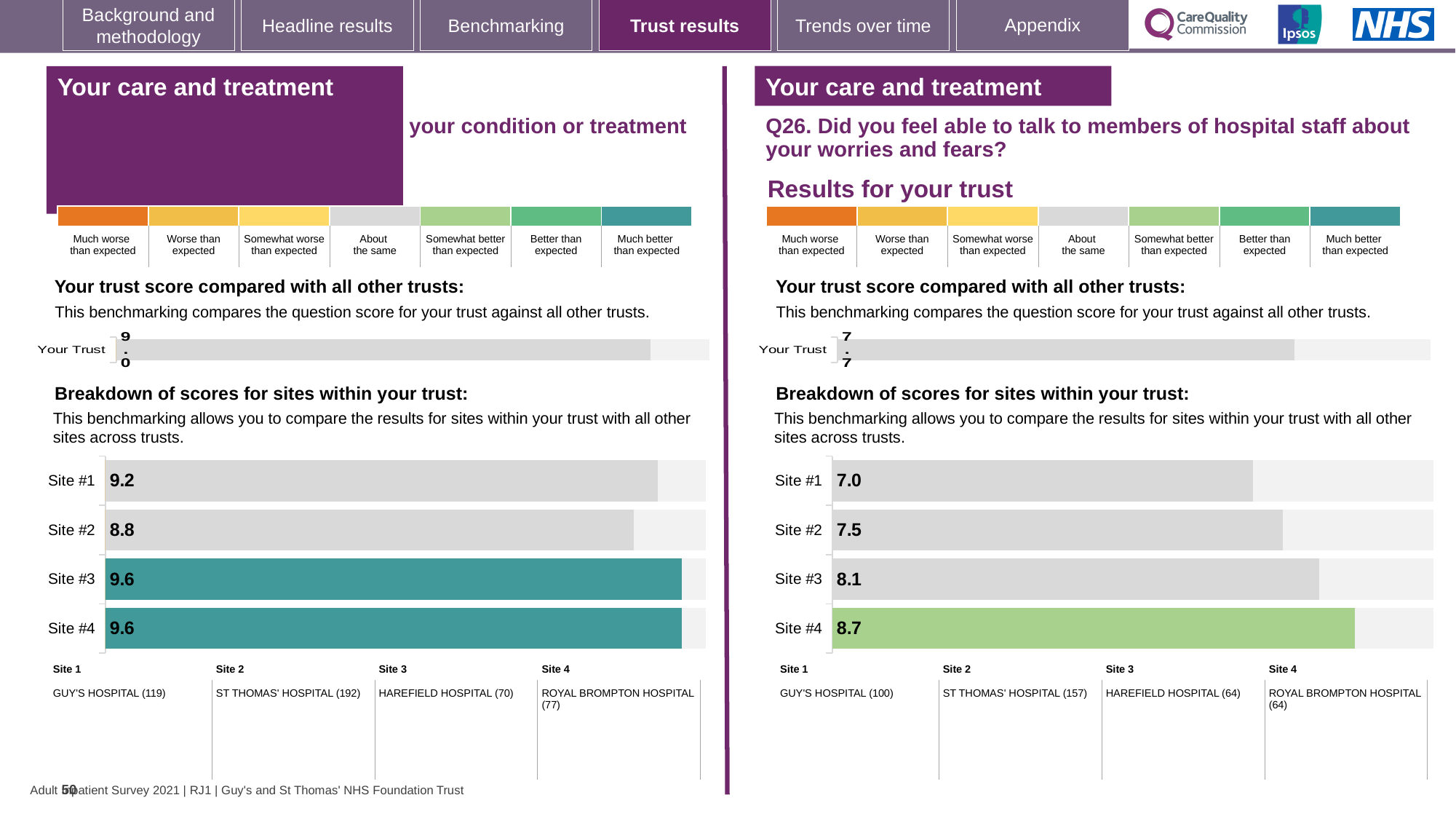
What type of chart is used for the 'Breakdown of scores for sites within your trust' on the right-hand side? Bar chart On the right-hand (Q26) site breakdown chart, which has the higher score, Site #2 or Site #3? Site #3 How many sites are shown on the left-hand site breakdown chart? 4 On the right-hand (Q26) 'Your trust score compared with all other trusts' chart, what is the score for Your Trust? 7.7 On the right-hand (Q26) site breakdown chart, which site has the lowest score? Site #1 On the left-hand 'Breakdown of scores for sites within your trust' chart, what is the score for Site #1? 9.2 On the right-hand (Q26) 'Breakdown of scores for sites within your trust' chart, what is the score for Site #4? 8.7 On the left-hand site breakdown chart, what is the difference between the scores for Site #1 and Site #2? 0.4 On the right-hand (Q26) site breakdown chart, which site has the highest score? Site #4 On the left-hand site breakdown chart, which site has the lowest score? Site #2 On the right-hand (Q26) site breakdown chart, what is the difference between the scores for Site #4 and Site #1? 1.7 On the right-hand (Q26) site breakdown chart, do the scores rise or fall from Site #1 to Site #4? Rise